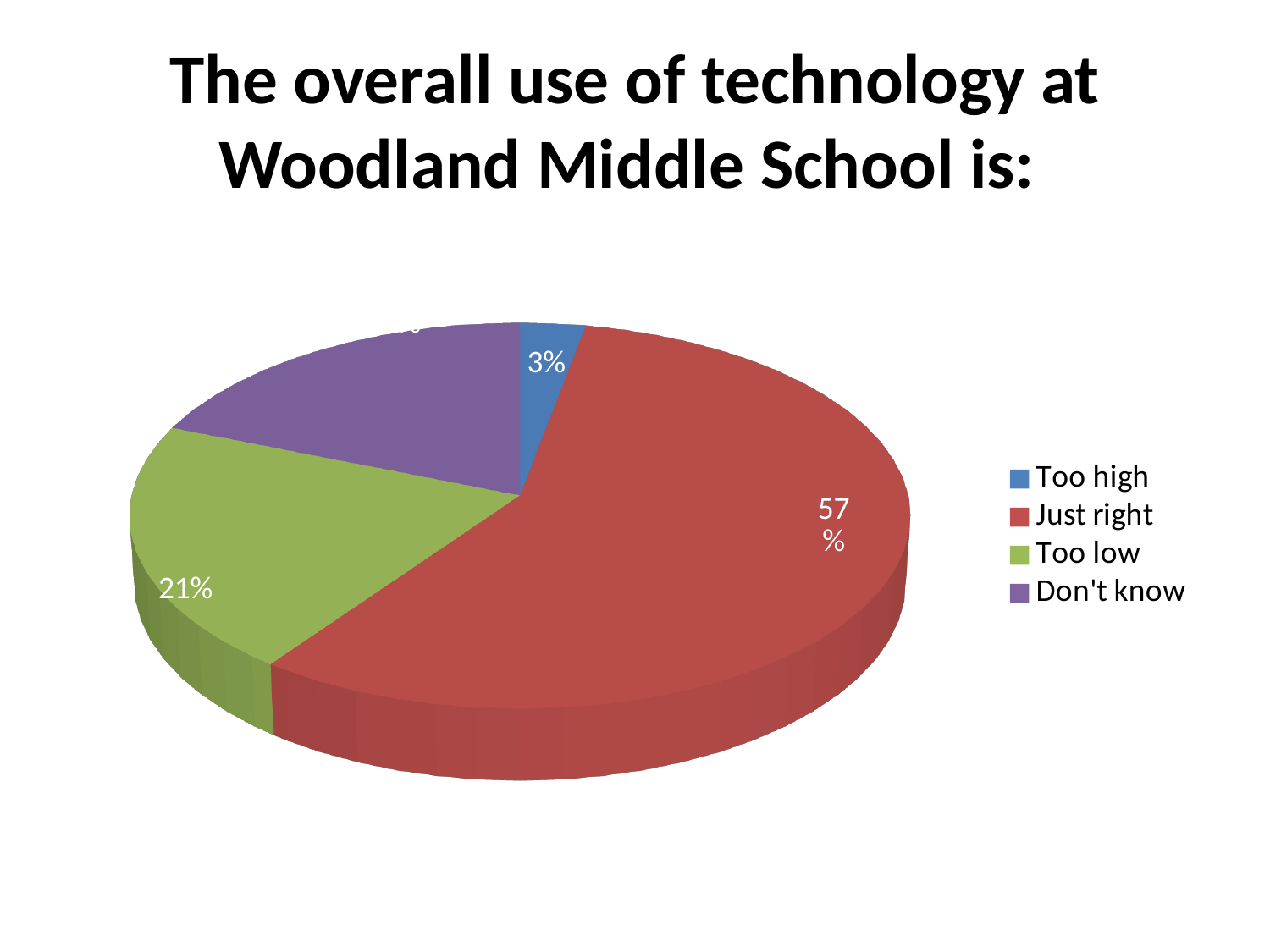
How many categories does the legend of the pie chart list? 4 What kind of chart is shown on the slide? Pie chart What is the difference in percentage points between the "Too low" and "Too high" slices? 18 What percentage of the pie chart is labelled "Too low"? 21% Which category has the smallest slice of the pie chart? Too high What is the difference in percentage points between the "Just right" and "Too low" slices? 36 What is the title of the chart on the slide? The overall use of technology at Woodland Middle School is: What colour is the "Just right" slice in the pie chart? Red What percentage of the pie chart is labelled "Too high"? 3% Which slice is larger, "Too low" or "Too high"? Too low What percentage of the pie chart is labelled "Just right"? 57% Which category has the largest slice of the pie chart? Just right